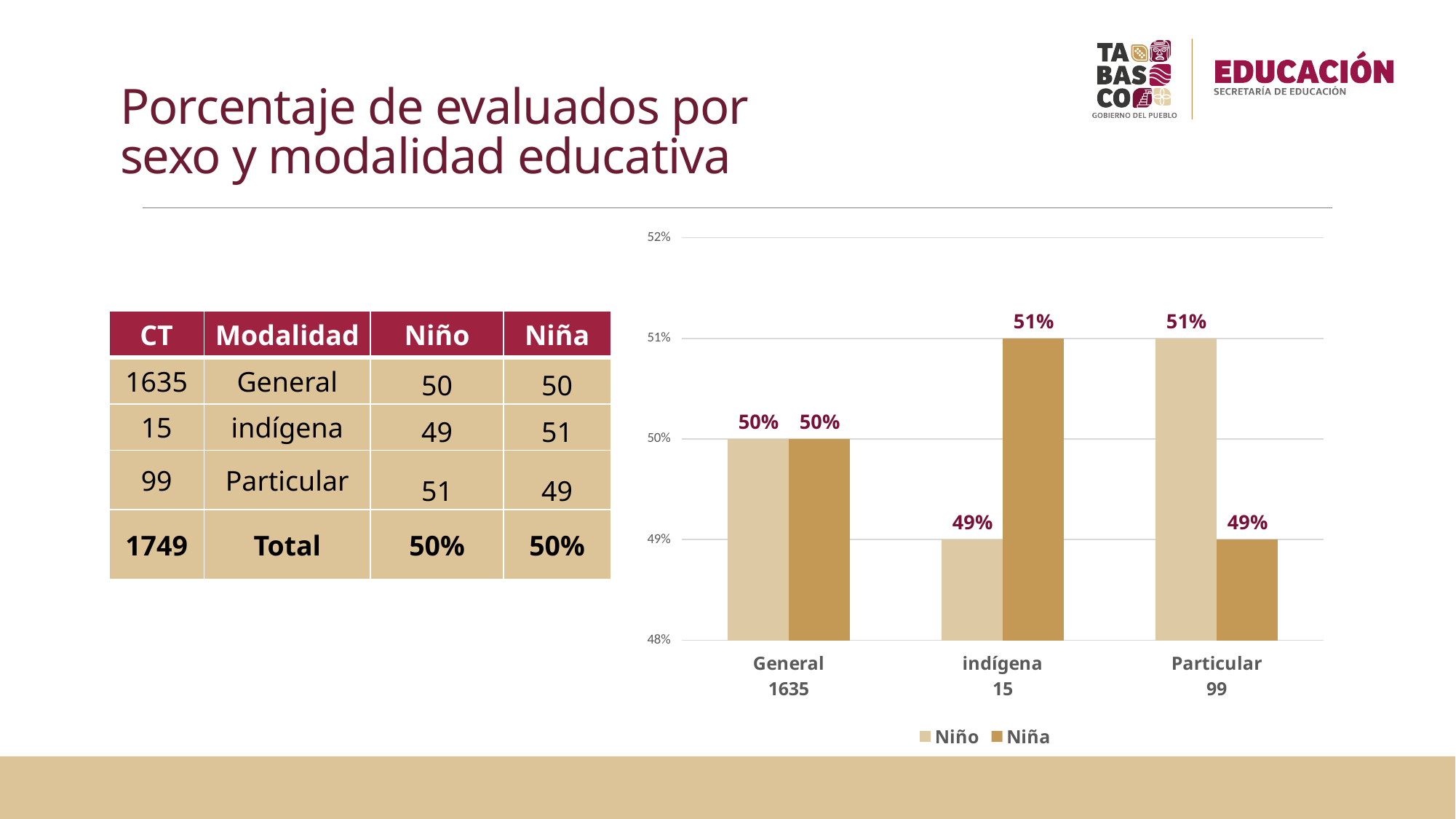
For Particular, which is larger, the Niño value or the Niña value? Niño What is the Niño value for Particular in the chart? 51% Which category has the highest Niña value? indígena What is the Niño value for General in the chart? 50% How many series does the chart legend list? 2 What is the Niña value for indígena in the chart? 51% Which category has the lowest Niño value? indígena How many categories are shown on the x axis of the chart? 3 What is the Niña value for Particular in the chart? 49% What kind of chart is shown on the slide? bar chart What is the difference between the Niña and Niño values for indígena? 2% What are the two series named in the chart legend? Niño and Niña